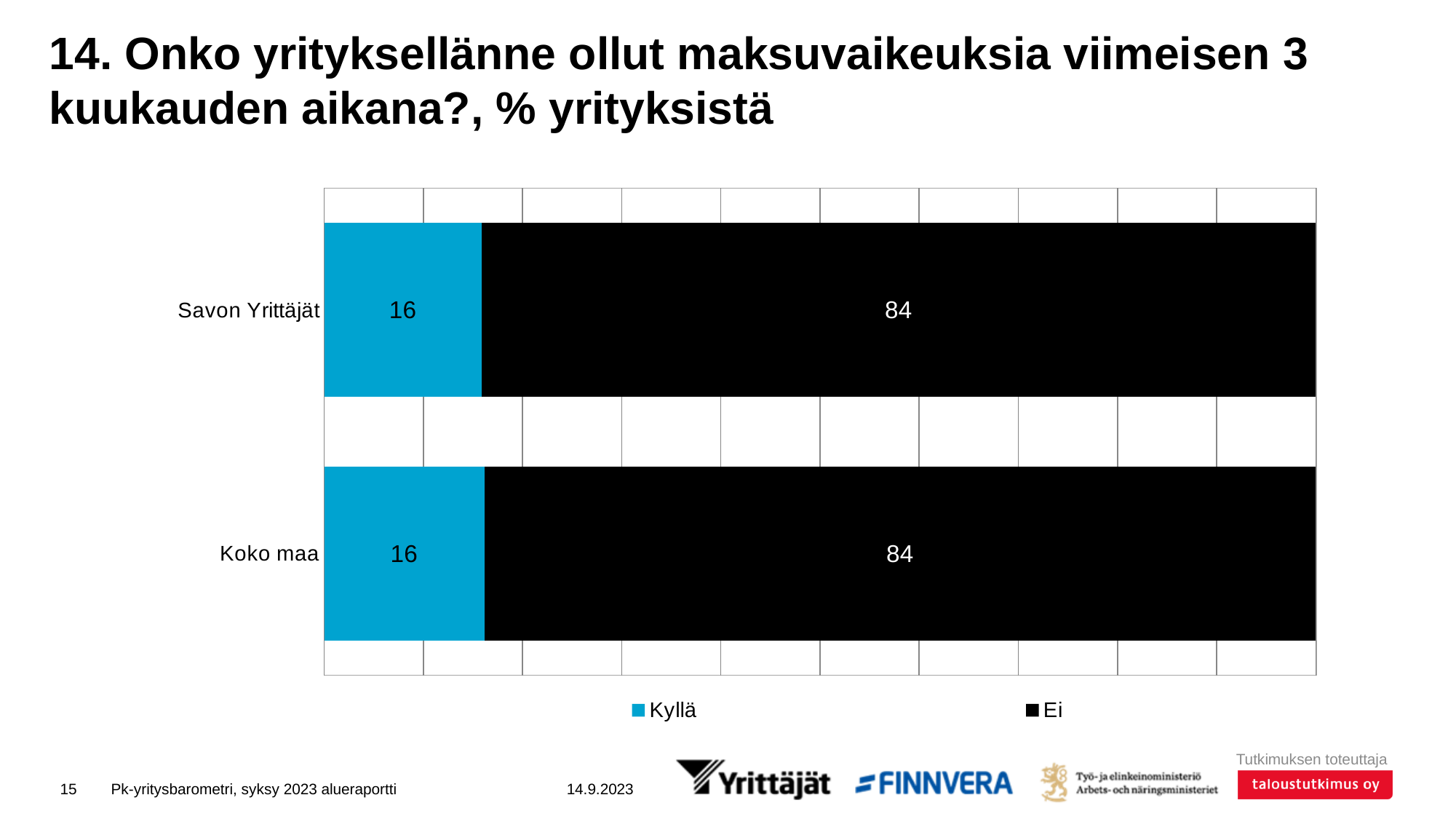
What is the total of the stacked bar for Koko maa? 100 What is the value for Ei for Savon Yrittäjät? 84 What is the value for Kyllä for Savon Yrittäjät? 16 What is the value for Ei for Koko maa? 84 How many series does the legend list? 2 Which series is shown in black? Ei What is the value for Kyllä for Koko maa? 16 Which series is shown in blue? Kyllä What kind of chart is shown on the slide? Stacked bar chart What is the difference between the Ei and Kyllä values for Savon Yrittäjät? 68 Which is larger for Koko maa, Kyllä or Ei? Ei How many categories are shown on the chart? 2